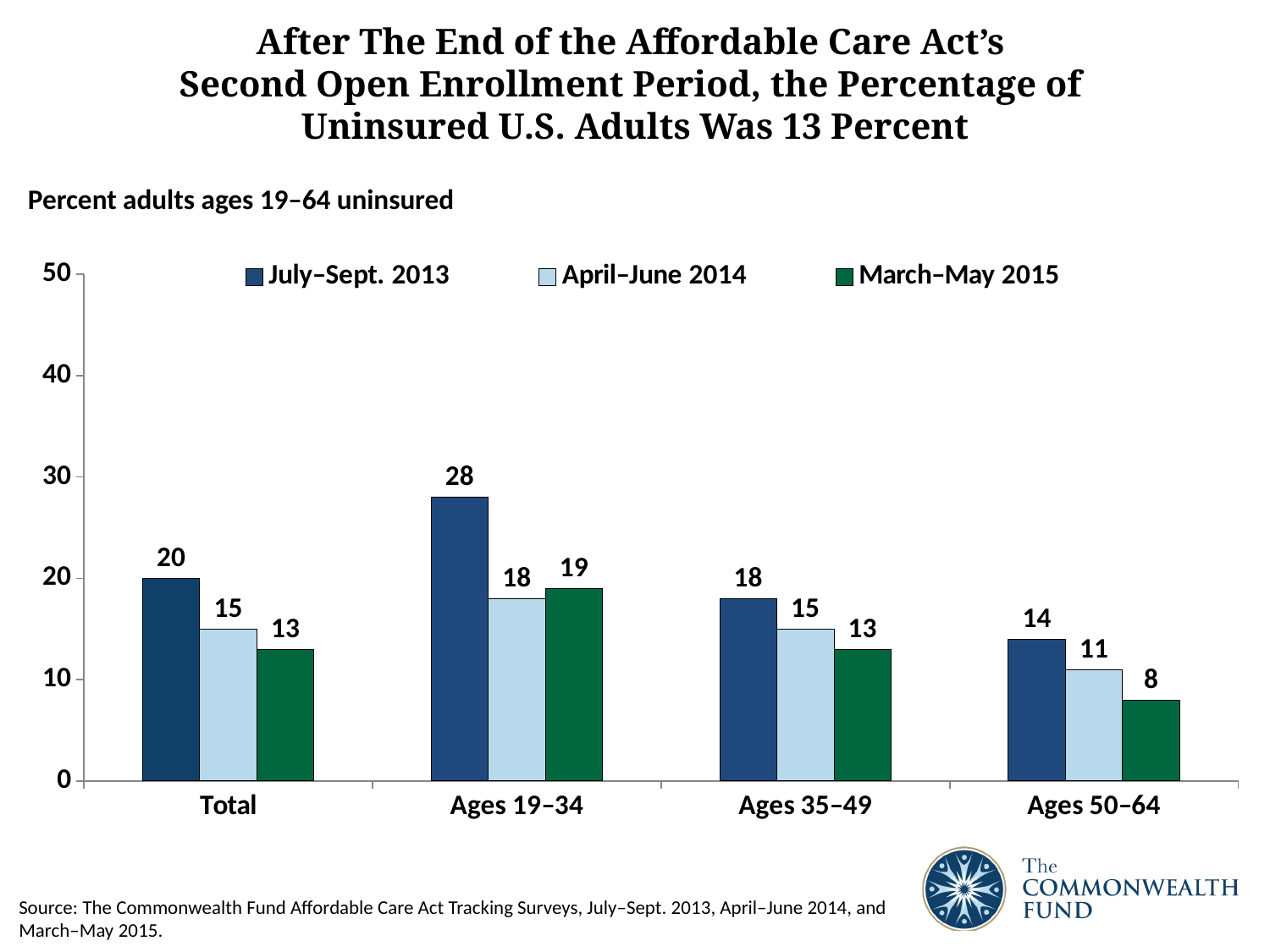
What is the value for Total in the April–June 2014 series? 15 What is the value for Ages 19–34 in the July–Sept. 2013 series? 28 What is the difference between the July–Sept. 2013 and March–May 2015 values for Ages 19–34? 9 Which category has the lowest value in the July–Sept. 2013 series? Ages 50–64 Is the July–Sept. 2013 value for Ages 19–34 greater or less than 30? less How many series does the legend list? 3 How many categories are shown on the x axis? 4 Which category has the highest value in the March–May 2015 series? Ages 19–34 What kind of chart is shown on the slide? bar chart What is the value for Ages 50–64 in the March–May 2015 series? 8 Which is larger: the April–June 2014 value for Ages 35–49 or the April–June 2014 value for Ages 50–64? Ages 35–49 Within the Total category, do the values rise or fall from July–Sept. 2013 to March–May 2015? fall